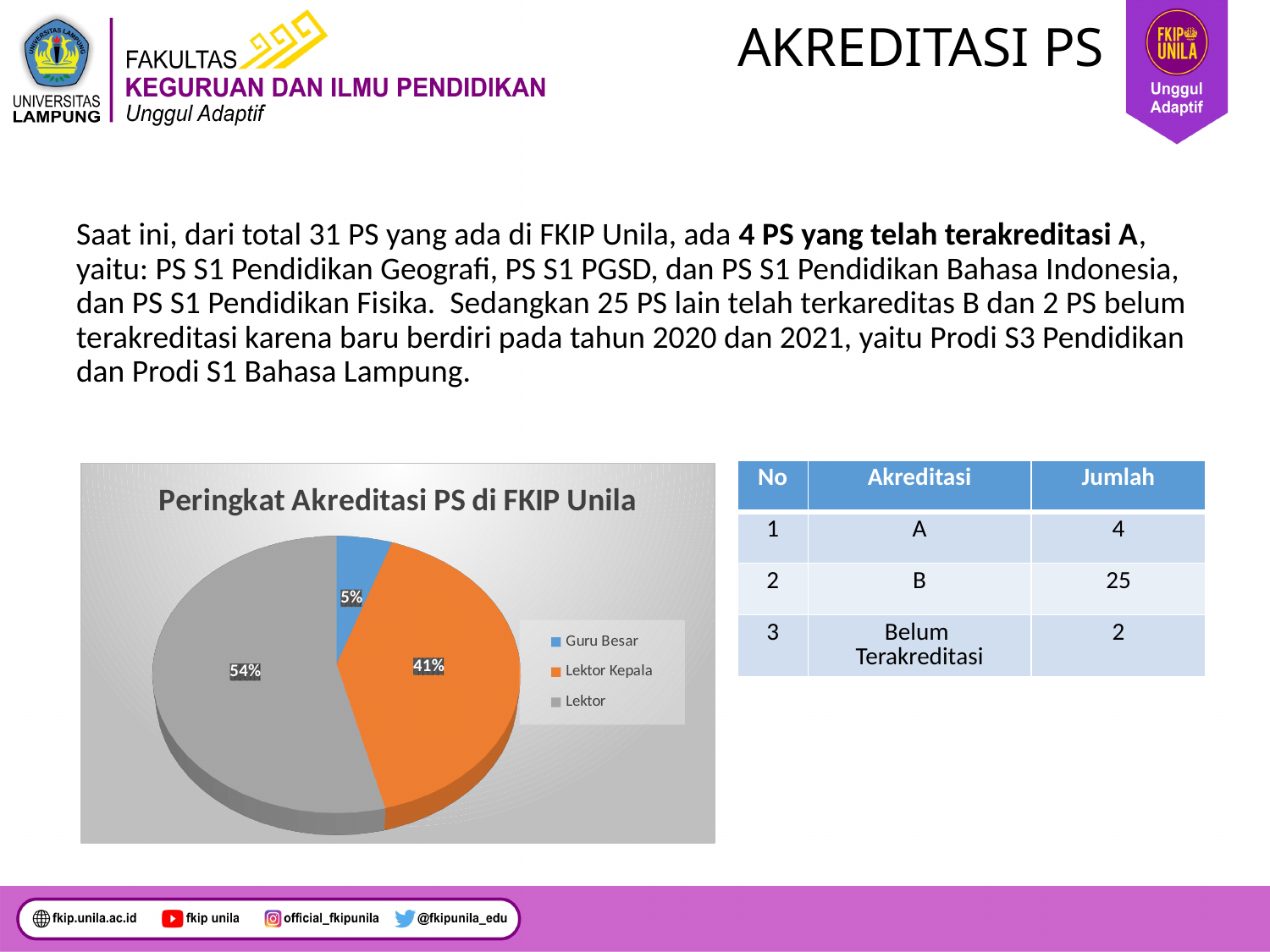
What kind of chart is shown on the slide? Pie chart Which slice of the pie chart is the largest? Lektor What colour is the Lektor Kepala slice in the pie chart? Orange How many entries does the pie chart's legend list? 3 What is the difference in percentage points between the Lektor and Lektor Kepala slices? 13 Which slice of the pie chart is the smallest? Guru Besar What is the title of the pie chart? Peringkat Akreditasi PS di FKIP Unila What percentage is shown for the Lektor slice? 54% How many slices does the pie chart have? 3 Which is larger, the Lektor Kepala slice or the Guru Besar slice? Lektor Kepala What percentage is shown for the Lektor Kepala slice? 41% What percentage is shown for the Guru Besar slice? 5%